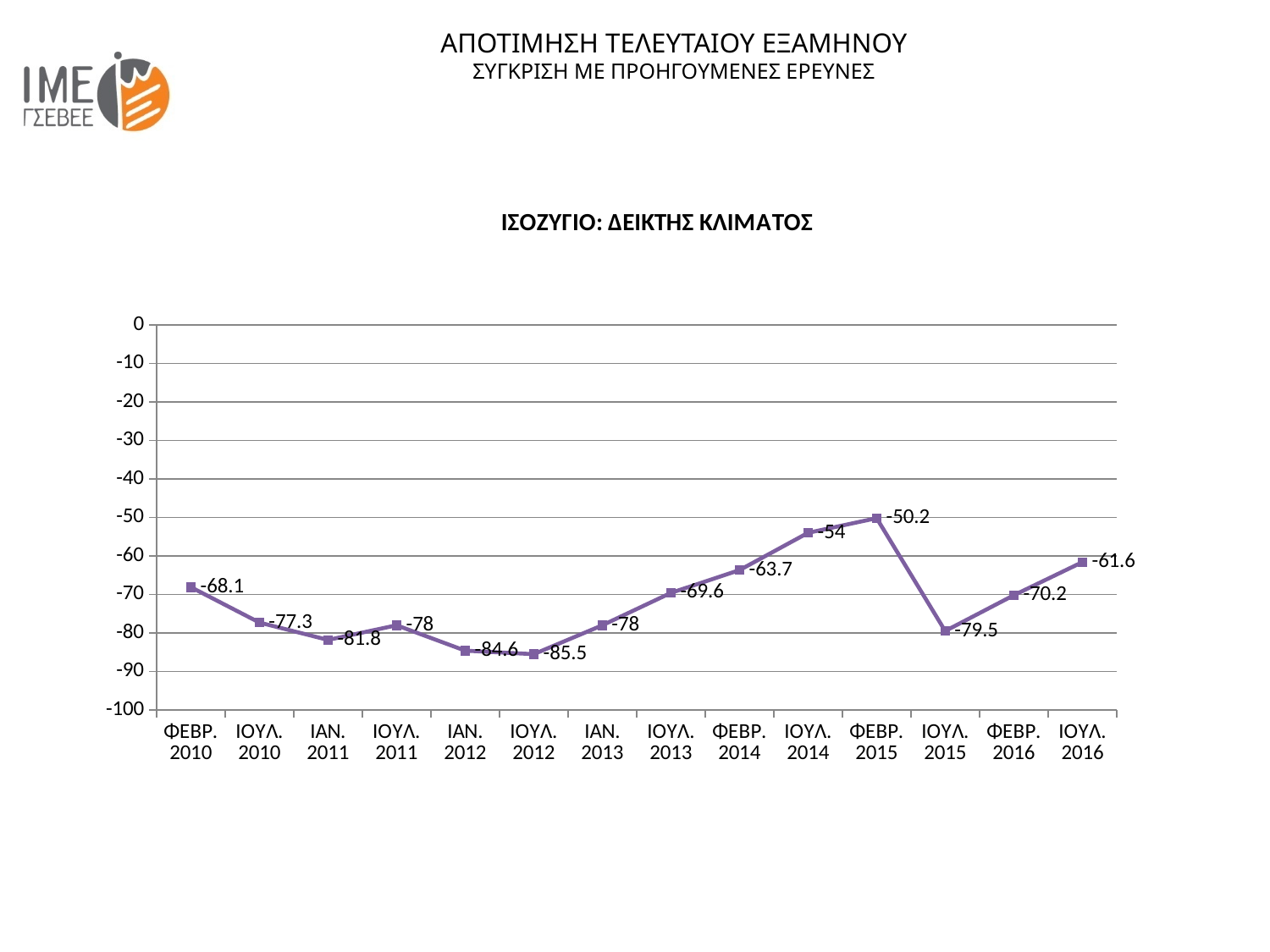
Which period has the lowest value? ΙΟΥΛ. 2012 How many data points are plotted on the chart? 14 What is the difference between the values for ΦΕΒΡ. 2015 and ΙΟΥΛ. 2015? 29.3 What is the value for ΦΕΒΡ. 2015? -50.2 What kind of chart is shown? Line chart Which is larger, the value for ΙΟΥΛ. 2014 or the value for ΙΟΥΛ. 2015? ΙΟΥΛ. 2014 What is the value for ΦΕΒΡ. 2010? -68.1 Which period has the highest value? ΦΕΒΡ. 2015 Do the values rise or fall from ΙΟΥΛ. 2012 to ΦΕΒΡ. 2015? Rise What is the difference between the values for ΙΟΥΛ. 2016 and ΦΕΒΡ. 2016? 8.6 What is the value for ΙΟΥΛ. 2012? -85.5 What is the value for ΙΟΥΛ. 2016? -61.6